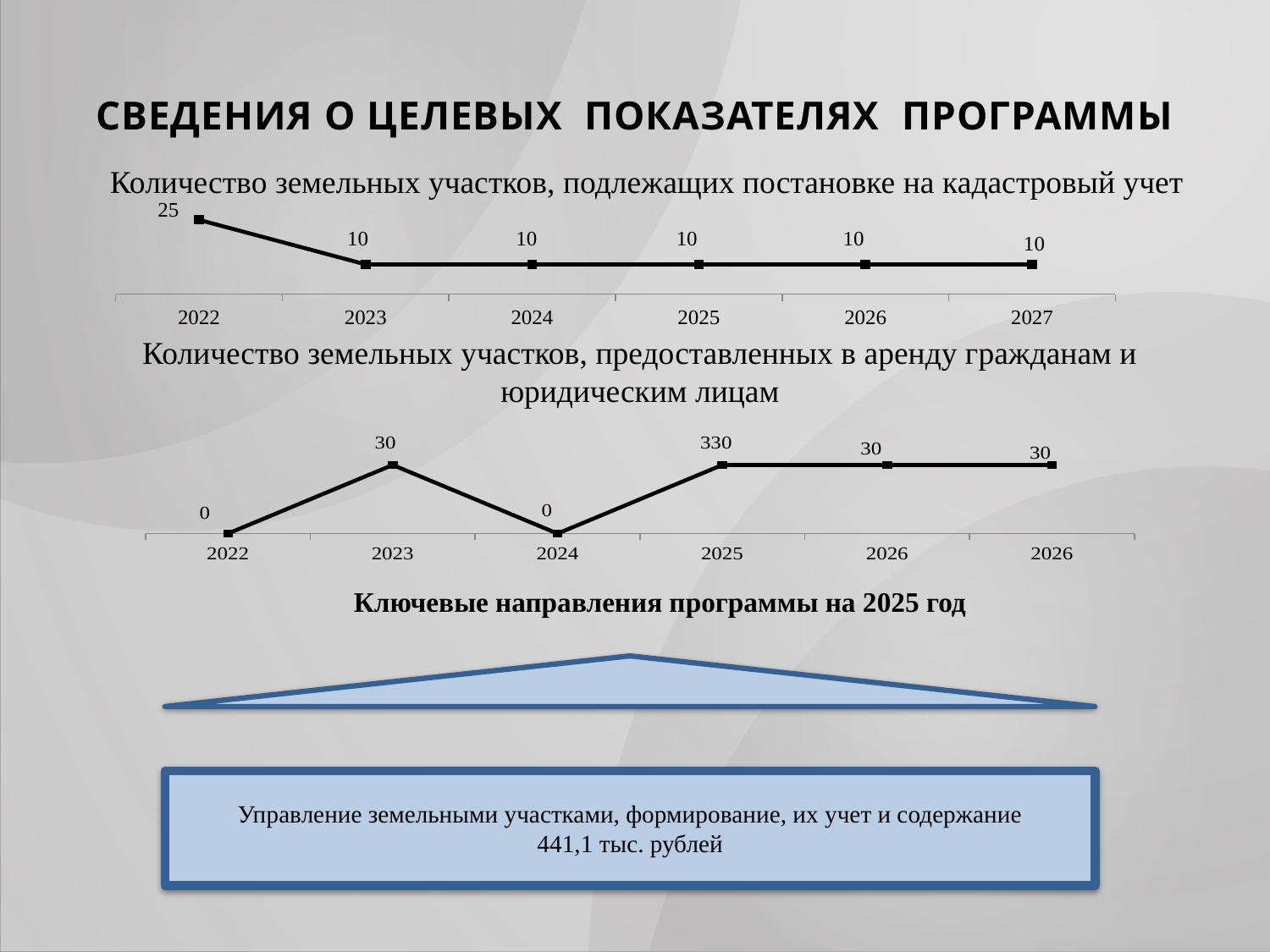
How many data points are plotted in the bottom chart, 'Количество земельных участков, предоставленных в аренду гражданам и юридическим лицам'? 6 What kind of chart is the top chart, 'Количество земельных участков, подлежащих постановке на кадастровый учет'? line chart In the top chart, 'Количество земельных участков, подлежащих постановке на кадастровый учет', what is the value for 2022? 25 In the bottom chart, 'Количество земельных участков, предоставленных в аренду гражданам и юридическим лицам', what is the value for 2023? 30 In the bottom chart, 'Количество земельных участков, предоставленных в аренду гражданам и юридическим лицам', which is larger, the value for 2023 or the value for 2024? 2023 In the top chart, 'Количество земельных участков, подлежащих постановке на кадастровый учет', which year has the highest value? 2022 In the top chart, 'Количество земельных участков, подлежащих постановке на кадастровый учет', what is the value for 2025? 10 How many data points are plotted in the top chart, 'Количество земельных участков, подлежащих постановке на кадастровый учет'? 6 In the top chart, 'Количество земельных участков, подлежащих постановке на кадастровый учет', what is the difference between the values for 2022 and 2023? 15 What is the title of the top chart on the slide? Количество земельных участков, подлежащих постановке на кадастровый учет In the top chart, 'Количество земельных участков, подлежащих постановке на кадастровый учет', do the values rise or fall from 2022 to 2023? fall In the bottom chart, 'Количество земельных участков, предоставленных в аренду гражданам и юридическим лицам', what is the value for 2024? 0